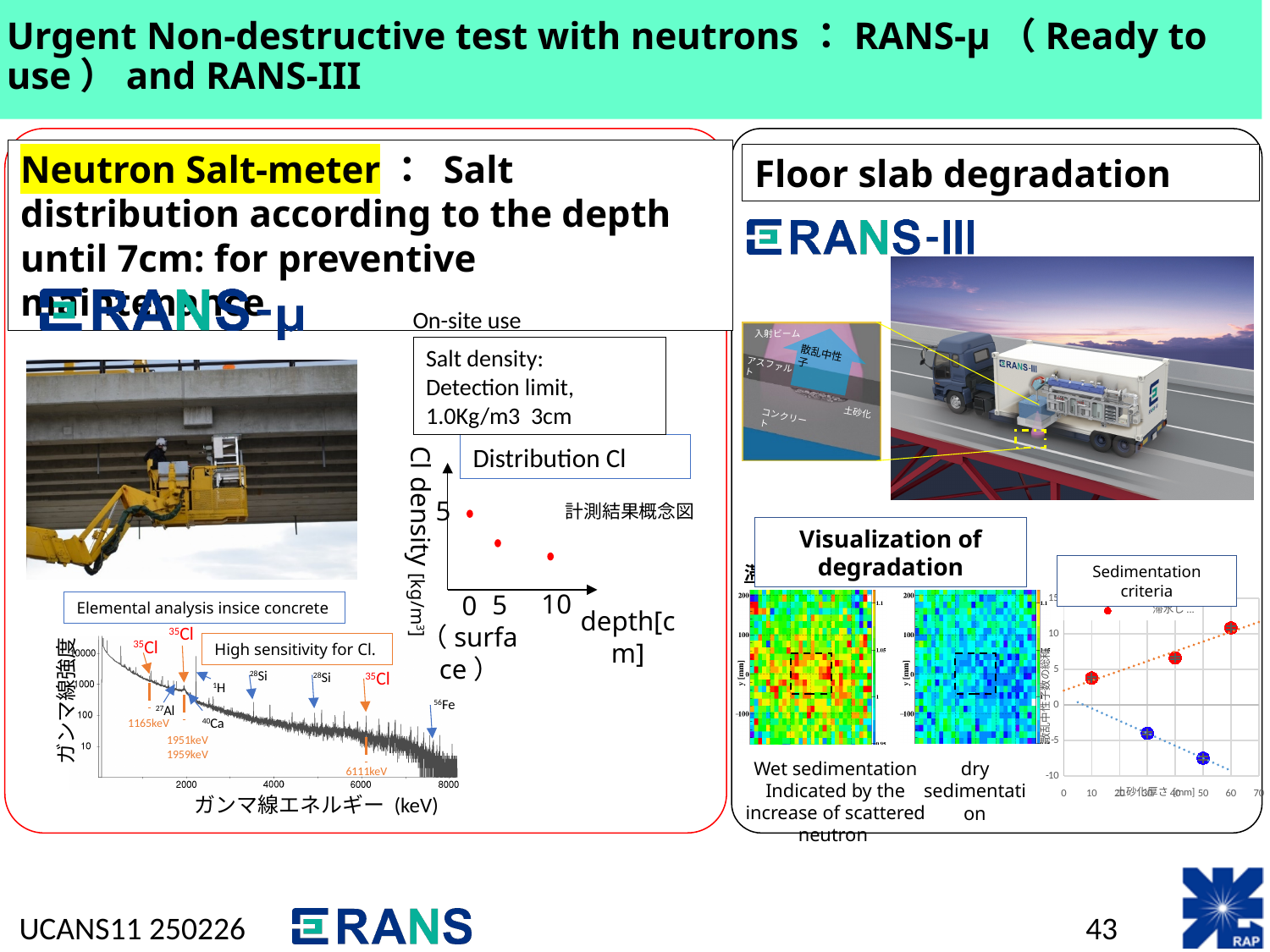
What kind of chart is the 'Distribution Cl' chart? scatter chart What kind of chart is the gamma-ray spectrum chart at the bottom left of the slide? line chart In the gamma-ray spectrum chart at the bottom left, what is the largest energy tick shown on the x axis? 8000 In the 'Distribution Cl' chart, is the Cl density of the point at the smallest depth greater or less than the point at the largest depth? greater In the 'Sedimentation criteria' chart, do the red points rise or fall as the x value increases? rise In the 'Distribution Cl' chart, do the Cl density values rise or fall as depth increases? fall In the 'Sedimentation criteria' chart, how many series of points are plotted? 2 In the 'Sedimentation criteria' chart, is the value of the red point near x = 40 greater or less than 5? greater In the 'Distribution Cl' chart, what quantity is plotted on the x axis? depth[cm] In the gamma-ray spectrum chart at the bottom left, does the gamma-ray intensity generally rise or fall as energy increases? fall In the 'Sedimentation criteria' chart, is the value of the blue point near x = 50 greater or less than -5? less In the 'Distribution Cl' chart, how many data points are plotted? 3